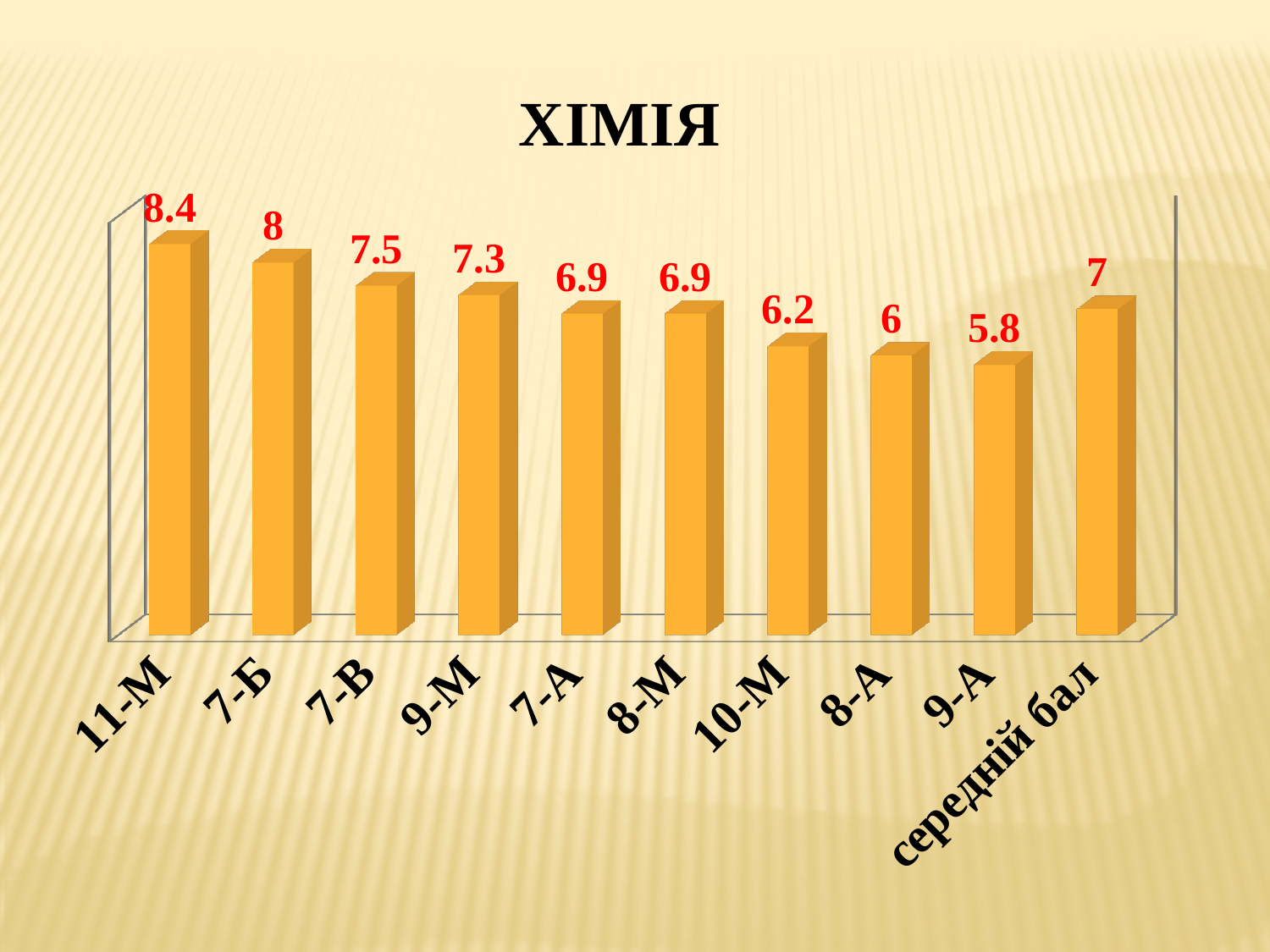
What is the difference between the values for 11-М and 9-А? 2.6 What is the value for середній бал? 7 What is the difference between the values for 7-Б and 8-А? 2 Which class has the lowest value? 9-А Do the values for the classes from 11-М to 9-А rise or fall along the x axis? fall How many bars are shown in the chart? 10 What is the value for 10-М? 6.2 What kind of chart is shown on the slide? bar chart What is the title of the chart? ХІМІЯ Which category has the highest value? 11-М What is the value for 11-М? 8.4 Which is larger, the value for 7-В or the value for 9-М? 7-В